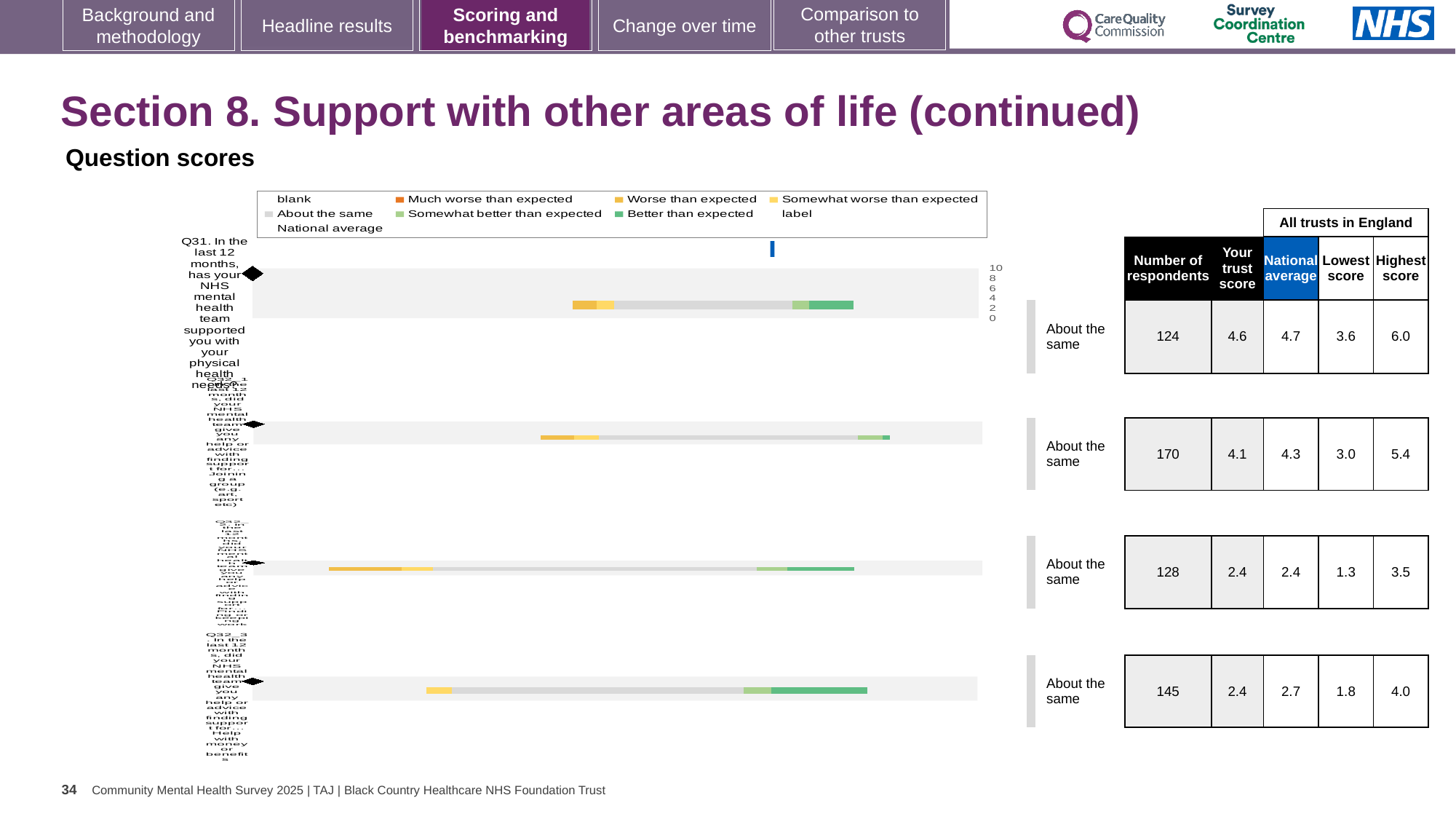
What colour does the legend use for 'Better than expected'? green For the first row (Q31), which is larger: your trust score or the national average? National average For the first row (Q31), what is the difference between the highest score and the lowest score? 2.4 What benchmark label is shown next to each of the four bars? About the same What is the first legend entry in the chart? blank In the table beside the chart, what is the number of respondents for the first row (Q31)? 124 In the table beside the chart, what is the national average for the first row (Q31)? 4.7 In the table beside the chart, what is 'Your trust score' for the first row (Q31)? 4.6 How many entries does the chart legend list? 9 How many question bars are plotted in the chart? 4 Which row in the table has the highest number of respondents? the second row (170) What kind of chart is shown under 'Question scores'? bar chart